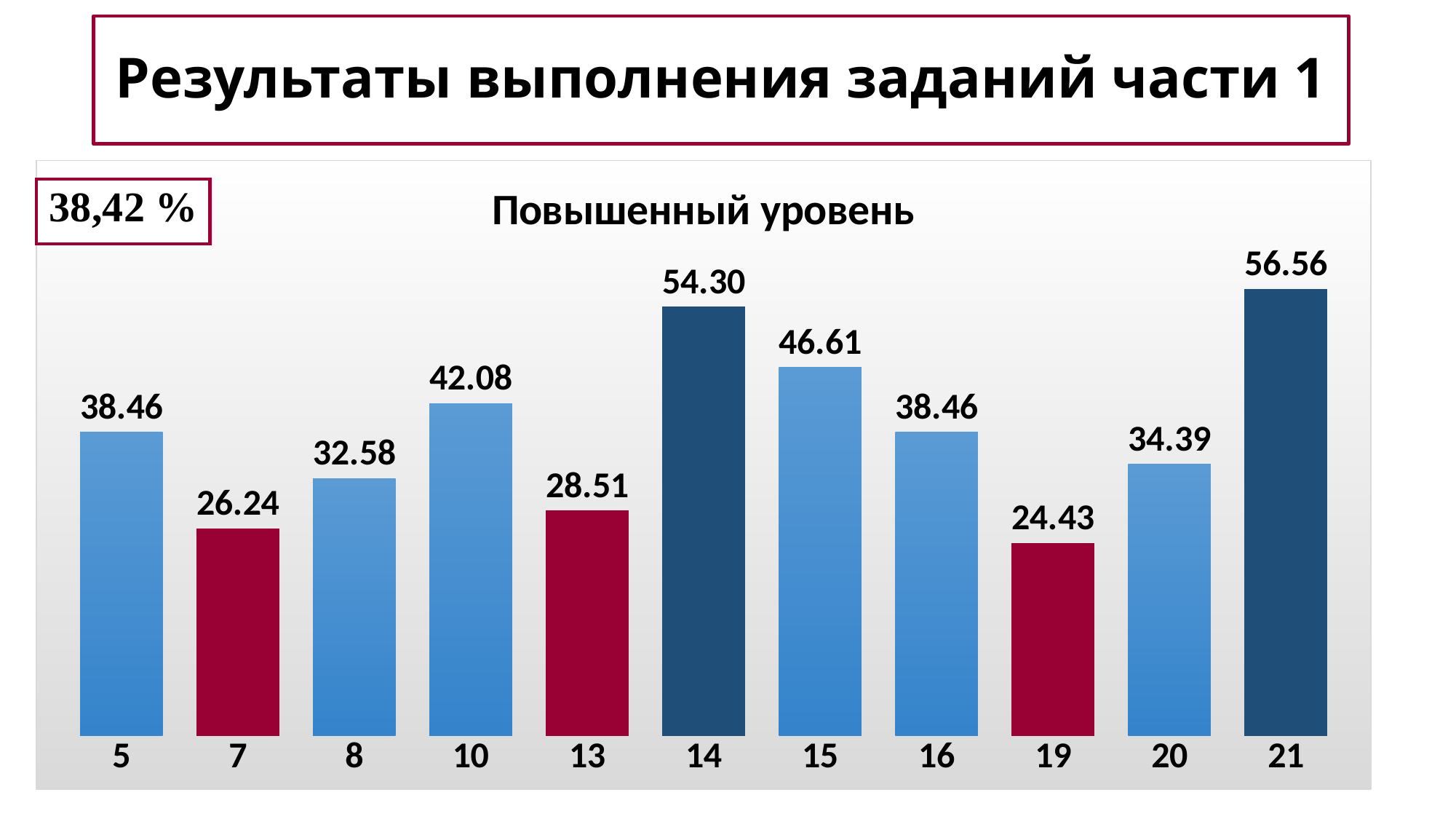
Which task has the highest value? 21 What is the value for task 14? 54.30 Which is larger, the value for task 13 or the value for task 7? task 13 What kind of chart is shown on the slide? bar chart What is the value for task 10? 42.08 What is the difference between the values for task 15 and task 7? 20.37 How many tasks are shown on the chart? 11 What is the difference between the values for task 21 and task 14? 2.26 Which is larger, the value for task 8 or the value for task 20? task 20 Which task has the lowest value? 19 What is the title of the chart? Повышенный уровень What is the value for task 19? 24.43